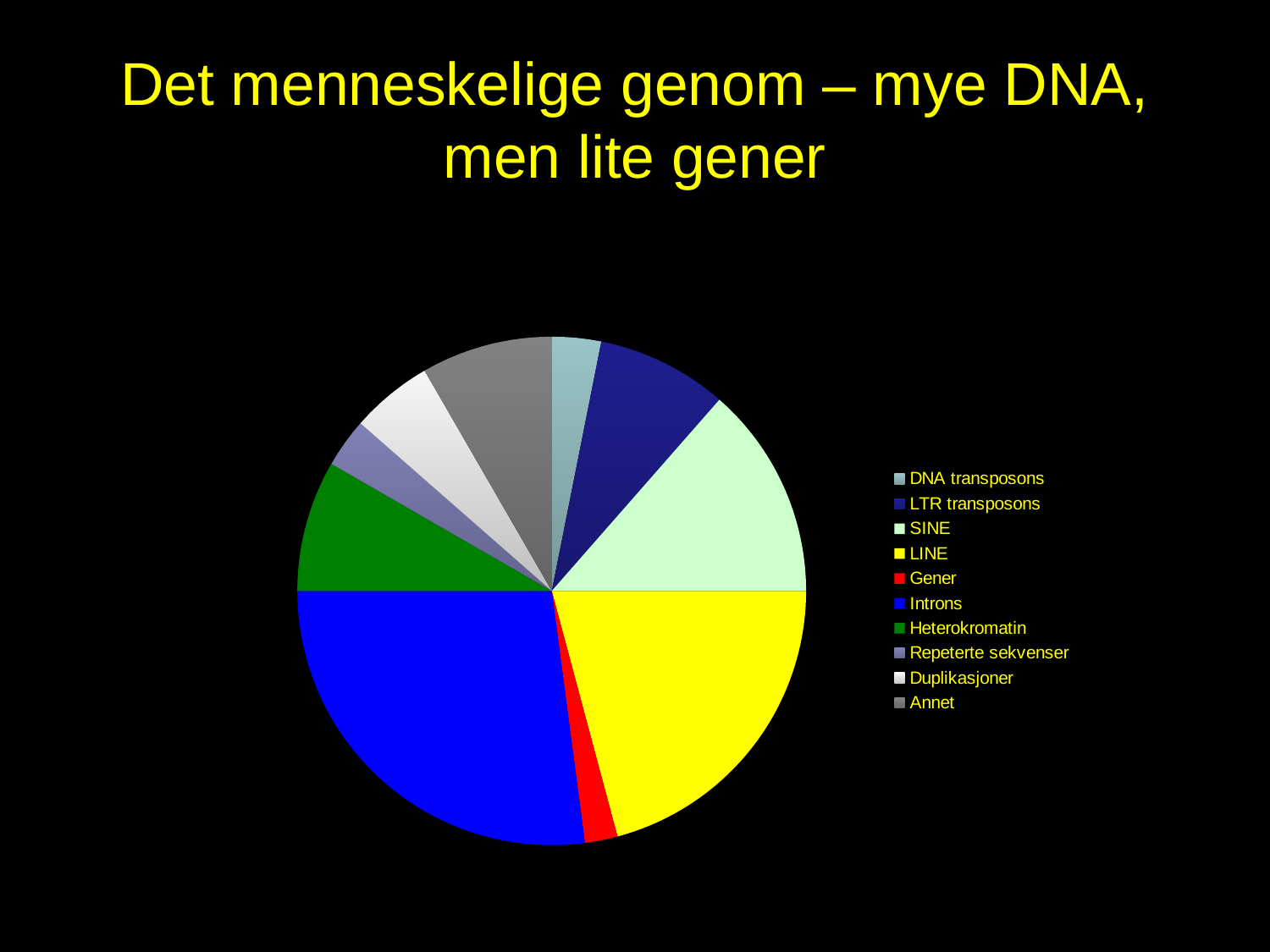
Which slice is larger, Gener or DNA transposons? DNA transposons What kind of chart is shown on the slide? pie chart How many categories does the pie chart's legend list? 10 Which slice is larger, Annet or Repeterte sekvenser? Annet What is the title of the slide containing the pie chart? Det menneskelige genom – mye DNA, men lite gener Which category has the largest slice of the pie chart? Introns Which slice is larger, Introns or LINE? Introns What colour is the Gener slice in the pie chart? red Which category has the smallest slice of the pie chart? Gener